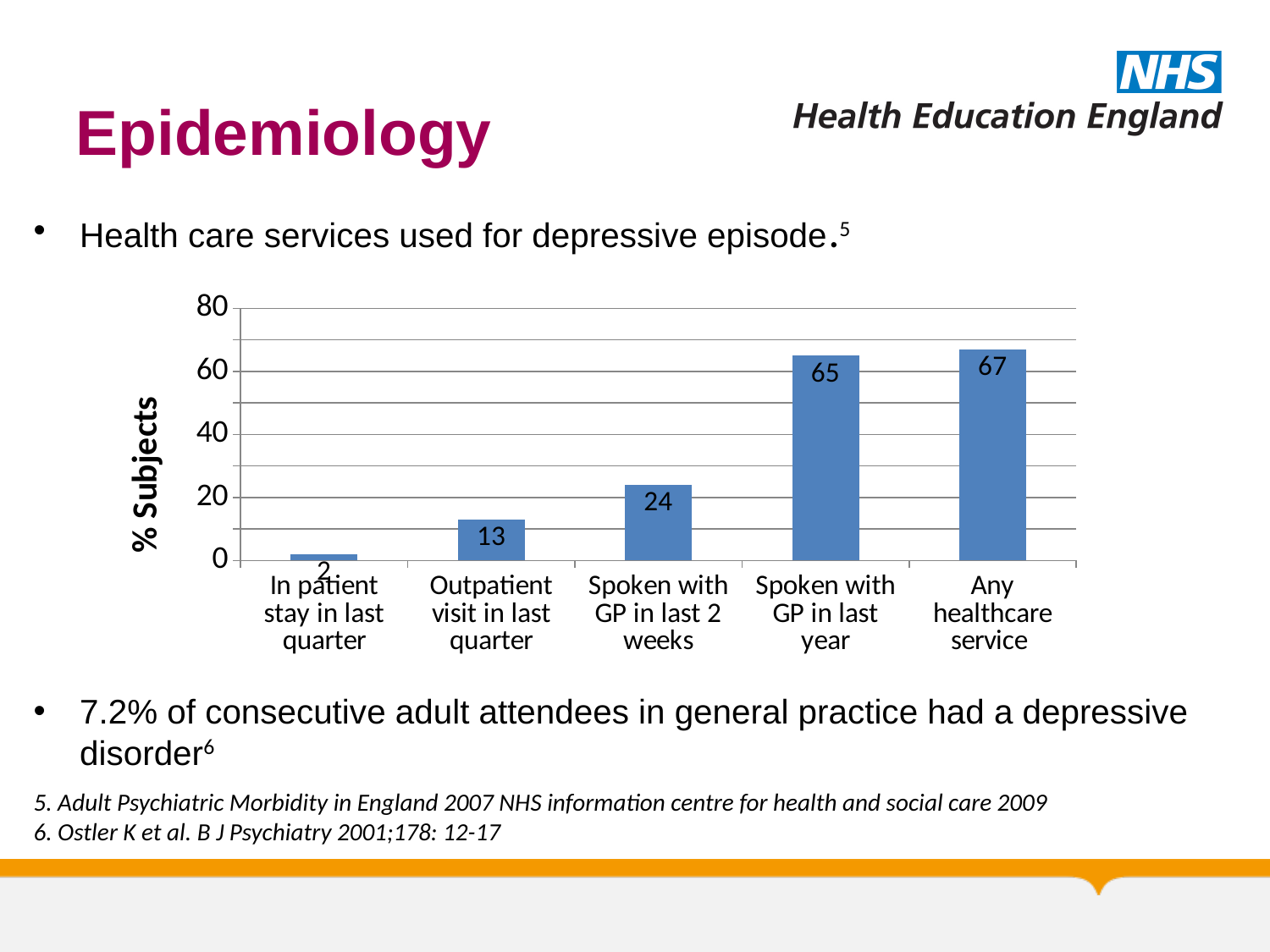
Which is larger, the value for "Outpatient visit in last quarter" or "Spoken with GP in last 2 weeks"? Spoken with GP in last 2 weeks Is the value for "Spoken with GP in last year" greater or less than 60? greater What is the value for "Spoken with GP in last 2 weeks"? 24 Which category has the lowest value? In patient stay in last quarter Which category has the highest value? Any healthcare service What is the value for "Spoken with GP in last year"? 65 How many categories are shown on the x axis? 5 What is the value for "In patient stay in last quarter"? 2 What kind of chart is shown on the slide? Bar chart What is the value for "Outpatient visit in last quarter"? 13 What is the label of the y axis? % Subjects What is the difference between the values for "Any healthcare service" and "Spoken with GP in last 2 weeks"? 43